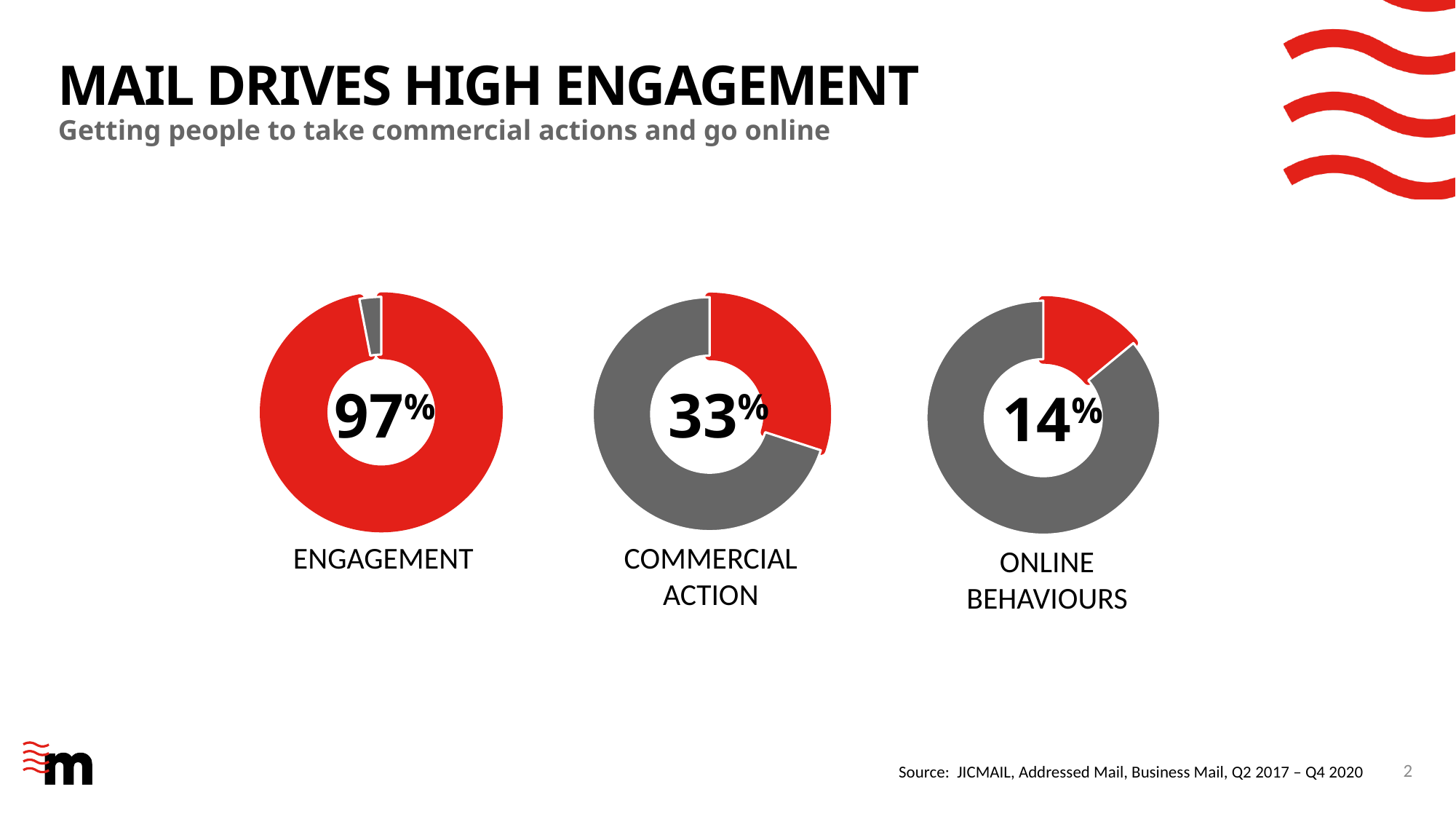
On the Commercial Action chart, what percentage is shown in the centre? 33% Which is larger, the Commercial Action percentage or the Online Behaviours percentage? Commercial Action What is the difference between the Engagement percentage and the Commercial Action percentage? 64% Across the three donut charts, which category has the lowest percentage? Online Behaviours What is the difference between the Commercial Action percentage and the Online Behaviours percentage? 19% On the Online Behaviours chart, what share of the ring is coloured red? 14% How many donut charts are shown on the slide? 3 What kind of chart is used to show the Engagement figure? Donut chart On the Commercial Action chart, what colour is the slice representing the 33% value? Red Across the three donut charts, which category has the highest percentage? Engagement On the Engagement chart, what percentage is shown in the centre? 97% On the Online Behaviours chart, what percentage is shown in the centre? 14%